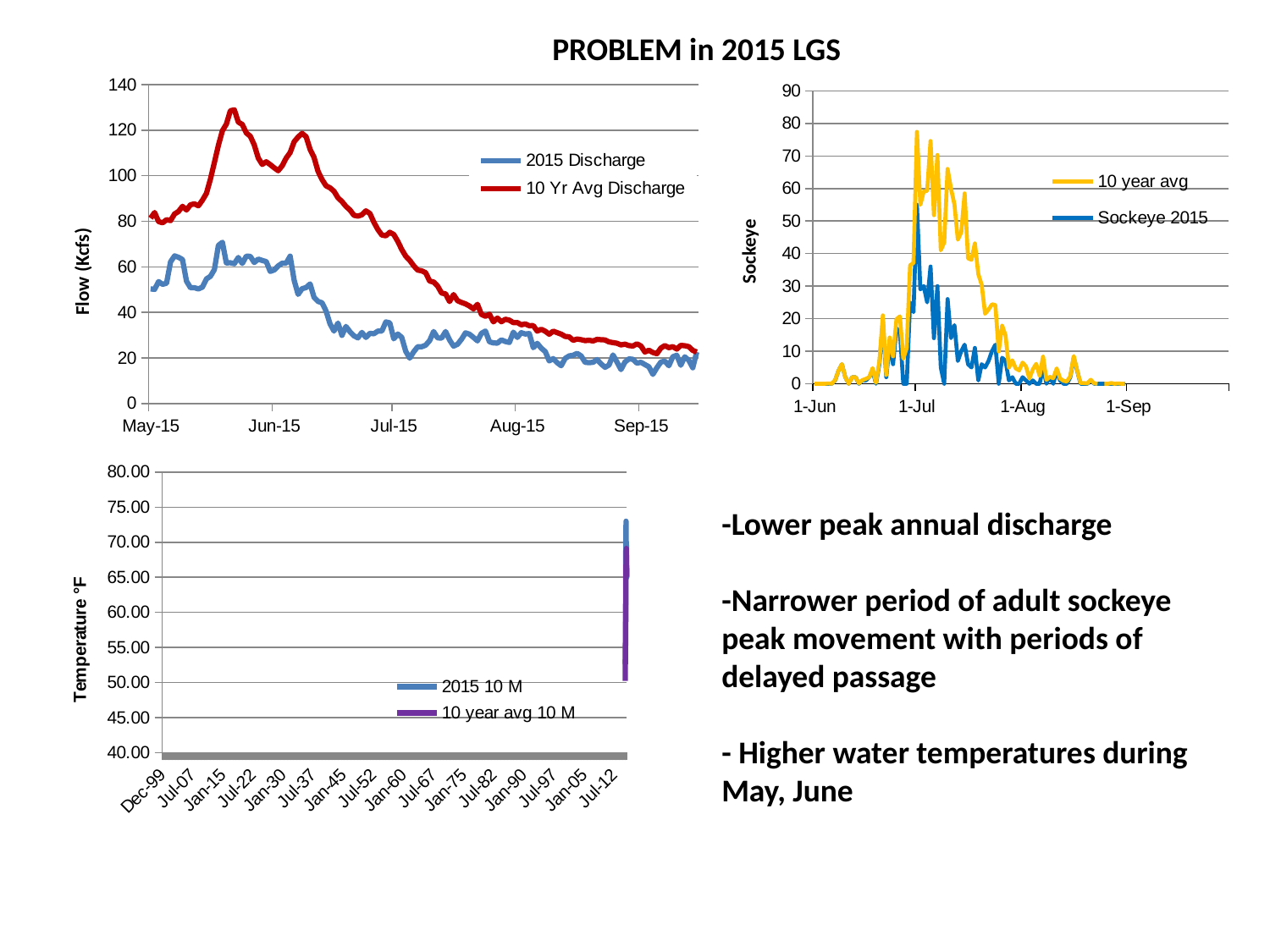
What is the y-axis label of the top-left chart? Flow (Kcfs) What kind of chart is the top-left chart? line chart In the top-right chart, how many series does the legend list? 2 In the top-left chart, what are the two series named in the legend? 2015 Discharge and 10 Yr Avg Discharge In the top-left chart, which series has the higher value at Jun-15: 2015 Discharge or 10 Yr Avg Discharge? 10 Yr Avg Discharge In the top-left chart, is the peak value of the 2015 Discharge series greater or less than 80? less In the top-left chart, how many series does the legend list? 2 In the top-left chart, does the 10 Yr Avg Discharge series rise or fall from Jul-15 to Sep-15? fall In the top-right chart, is the peak value of the Sockeye 2015 series greater or less than 40? greater In the top-left chart, is the peak value of the 10 Yr Avg Discharge series greater or less than 120? greater